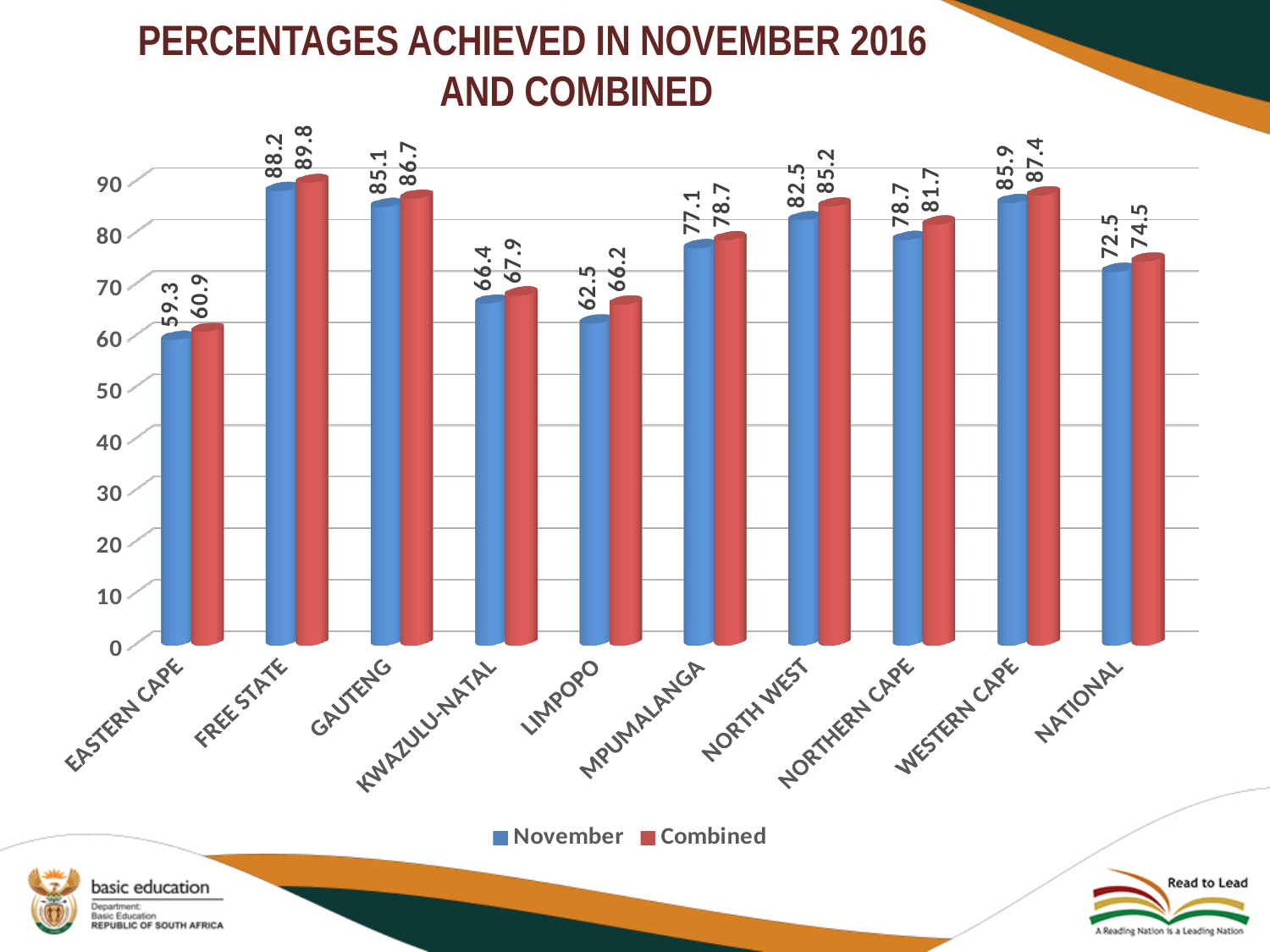
Which category has the highest November value? Free State Which is larger, the November value for Western Cape or the November value for North West? Western Cape How many categories are shown on the x axis? 10 What kind of chart is shown on the slide? bar chart Which category has the lowest Combined value? Eastern Cape What is the Combined value for National? 74.5 What is the difference between the Combined and November values for Northern Cape? 3.0 What colour are the Combined bars? red How many series does the legend list? 2 What is the November value for Gauteng? 85.1 Is the November value for KwaZulu-Natal greater or less than 70? less What is the Combined value for Limpopo? 66.2